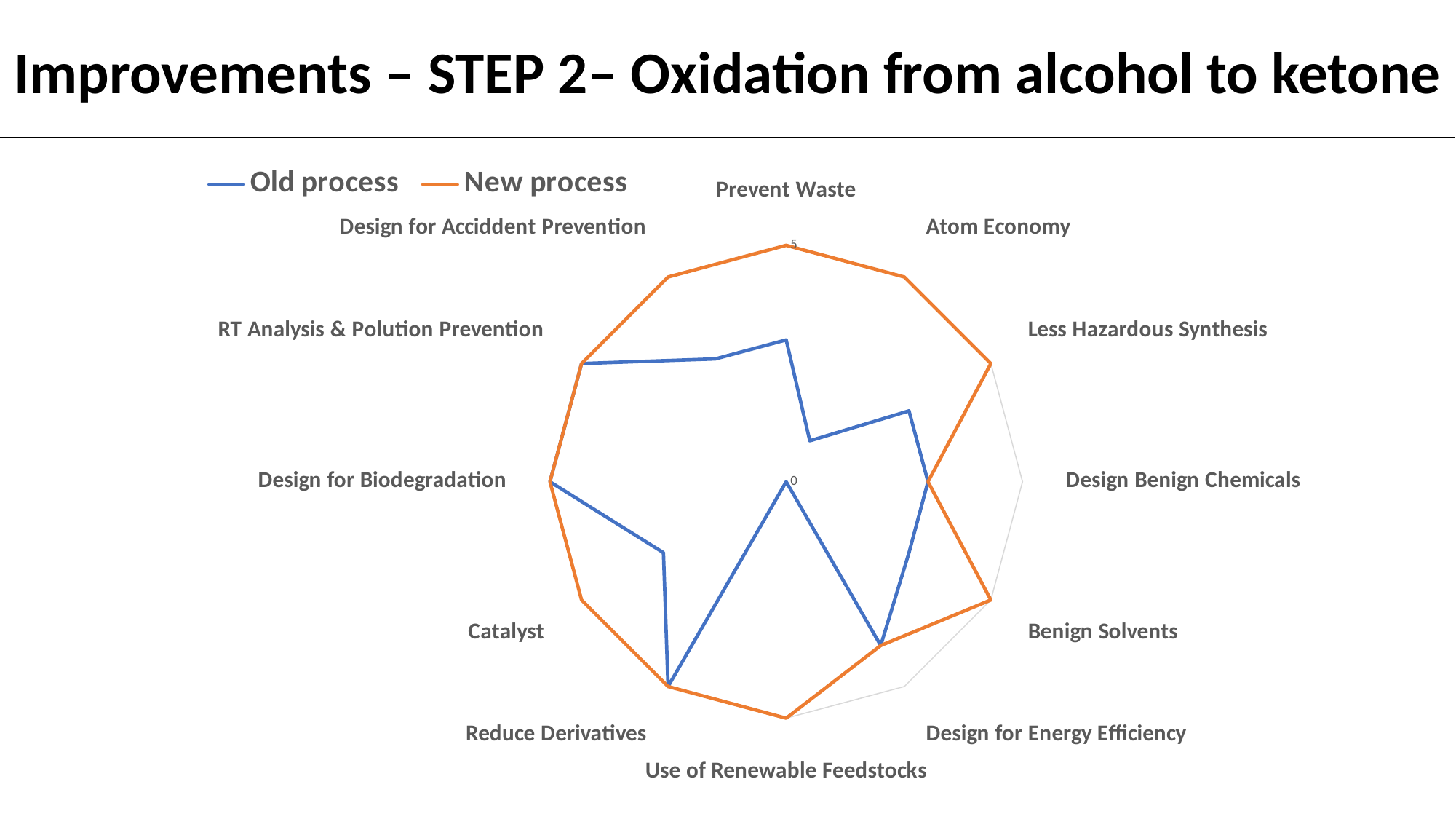
Which category has the lowest Old process value? Use of Renewable Feedstocks What is the Old process value for Use of Renewable Feedstocks? 0 How many categories (axes) does the radar chart have? 12 Which series is drawn in blue? Old process What kind of chart is shown on the slide? Radar chart How many series does the legend list? 2 Which category has the lowest New process value? Design Benign Chemicals What is the New process value for Prevent Waste? 5 For Atom Economy, which series has the larger value, Old process or New process? New process Is the Old process value for Atom Economy greater or less than 5? less Which series is drawn in orange? New process For Catalyst, which series has the larger value, Old process or New process? New process